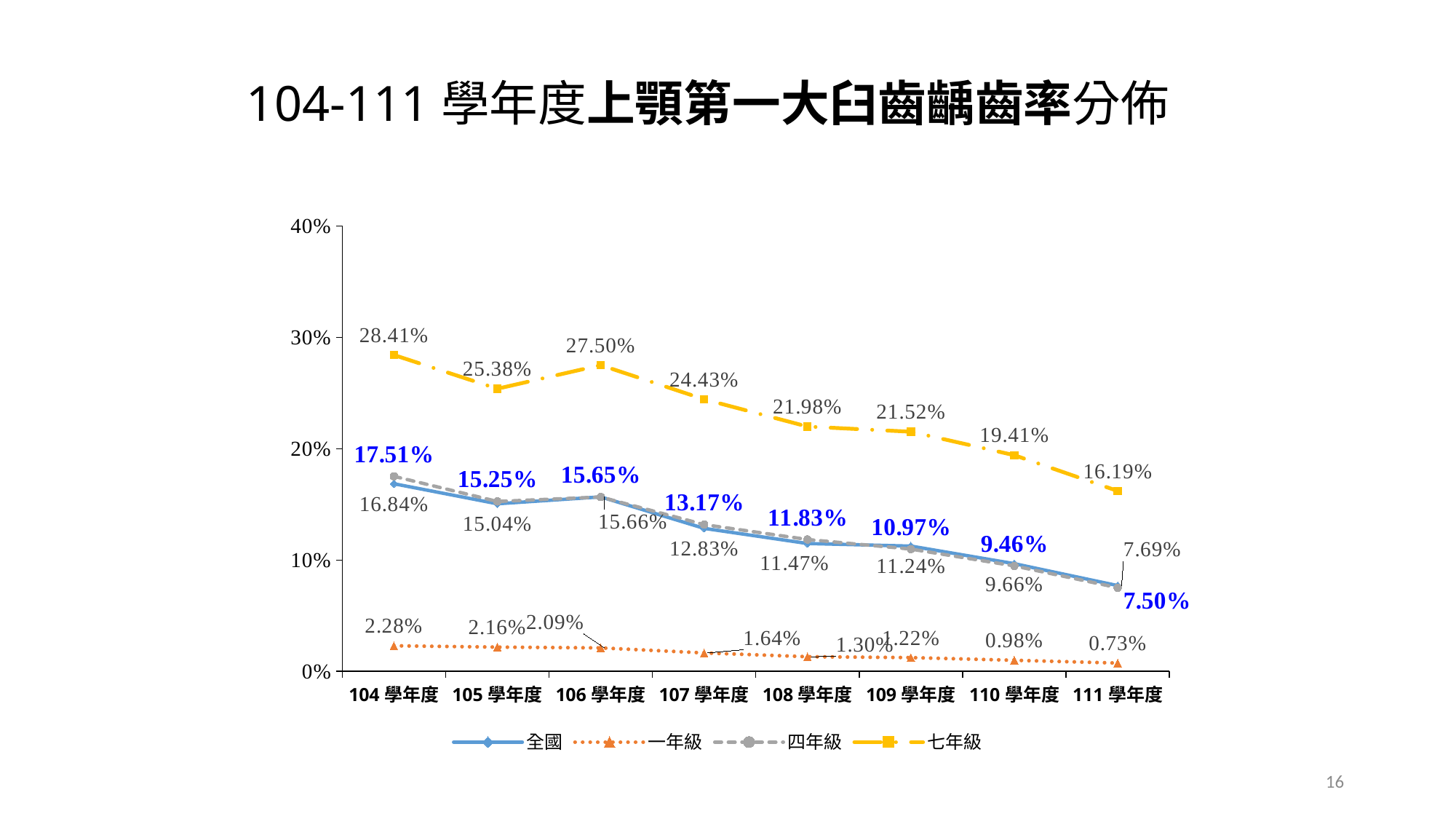
Which is larger for 七年級: the value in 105 學年度 or in 106 學年度? 106 學年度 What kind of chart is shown on the slide? line chart How many series does the legend list? 4 How many school years (學年度) are plotted along the x axis? 8 What is the value for 七年級 in 111 學年度? 16.19% What is the value for 七年級 in 104 學年度? 28.41% What is the value for 全國 in 111 學年度? 7.69% In which school year is the 一年級 value lowest? 111 學年度 Overall, does the 七年級 line rise or fall from 104 學年度 to 111 學年度? fall In which school year is the 七年級 value highest? 104 學年度 What is the difference between the 七年級 values in 104 學年度 and 111 學年度? 12.22 percentage points What is the value for 一年級 in 104 學年度? 2.28%